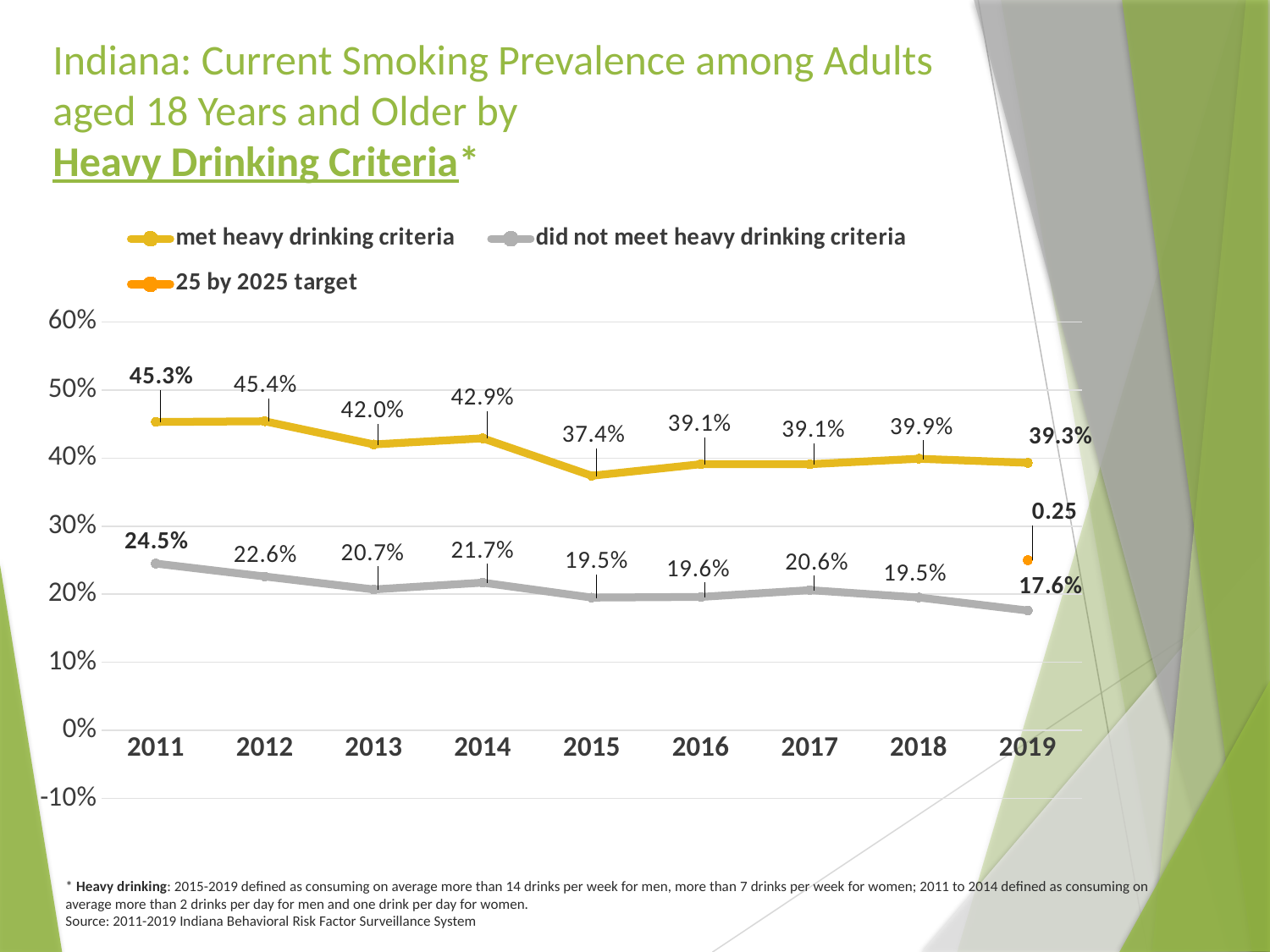
What was the smoking prevalence among adults who met heavy drinking criteria in 2015? 37.4% How many series does the legend list? 3 In which year was smoking prevalence highest among adults who did not meet heavy drinking criteria? 2011 What kind of chart is shown on the slide? line chart What is the difference between the 2019 values for those who met and those who did not meet heavy drinking criteria? 21.7 percentage points Is the 2011 value for those who met heavy drinking criteria greater or less than 40%? greater Overall, did smoking prevalence among adults who met heavy drinking criteria rise or fall from 2011 to 2019? fall What value is shown for the 25 by 2025 target in 2019? 0.25 In which year was smoking prevalence lowest among adults who met heavy drinking criteria? 2015 How many years are shown on the x axis? 9 Which was larger in 2014: the value for those who met heavy drinking criteria or those who did not? met heavy drinking criteria What was the smoking prevalence among adults who did not meet heavy drinking criteria in 2019? 17.6%